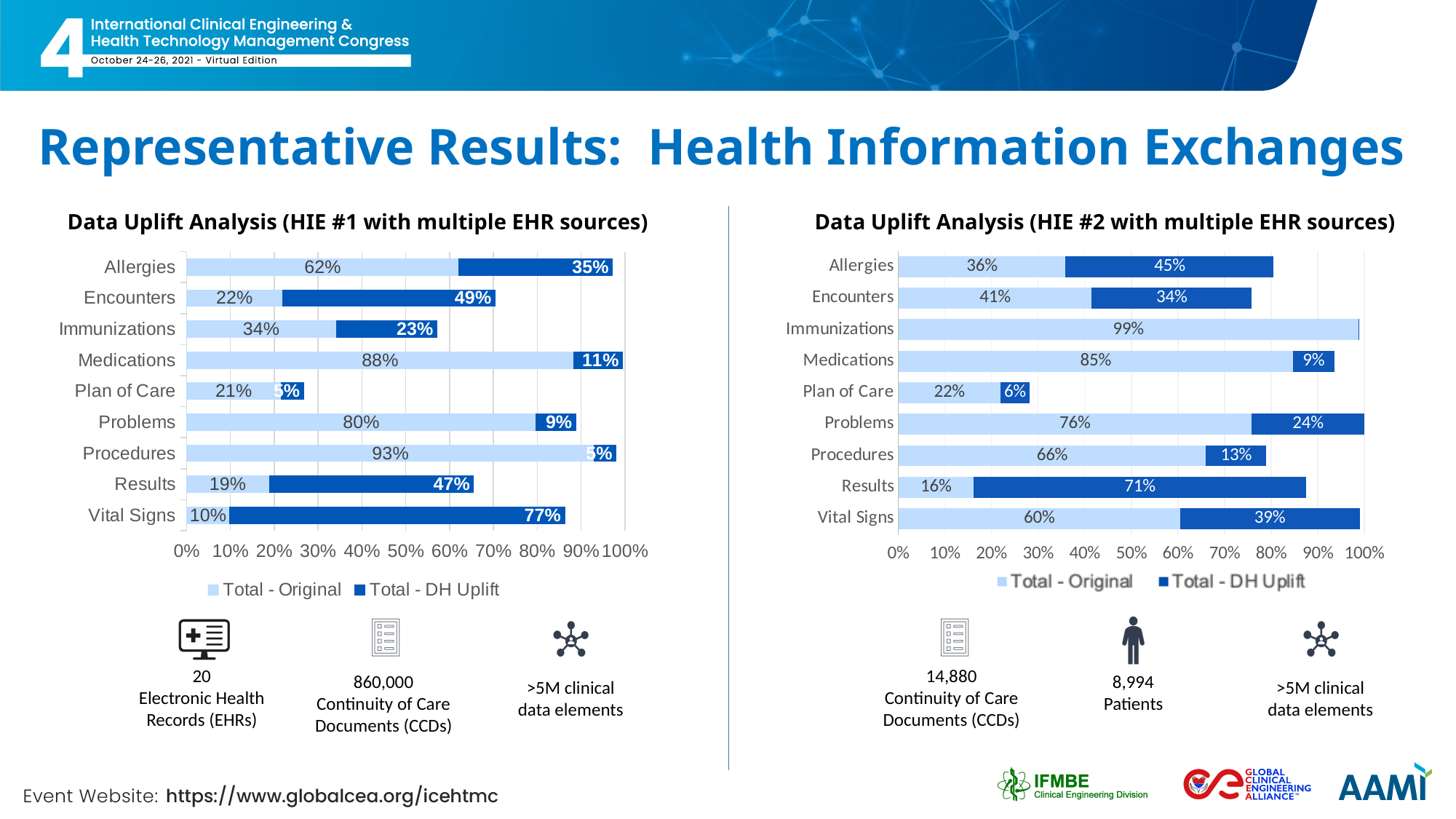
In the HIE #1 chart, what is the combined total of the Allergies bar (Original plus DH Uplift)? 97% In the HIE #2 chart, which category has the lowest Total - Original value? Results How many series does the legend of the HIE #1 chart list? 2 What type of chart is the Data Uplift Analysis (HIE #2) chart? Stacked bar chart In the HIE #2 chart, what is the Total - DH Uplift value for Results? 71% In the HIE #1 chart, what is the Total - DH Uplift value for Vital Signs? 77% In the HIE #2 chart, which is larger: the Total - DH Uplift value for Allergies or for Encounters? Allergies How many categories are shown in the HIE #2 chart? 9 In the HIE #2 chart, what is the Total - Original value for Immunizations? 99% In the HIE #1 chart, which category has the highest Total - Original value? Procedures In the HIE #1 chart, what is the difference between the Total - DH Uplift values for Vital Signs and Results? 30% In the HIE #1 chart, what is the Total - Original value for Medications? 88%